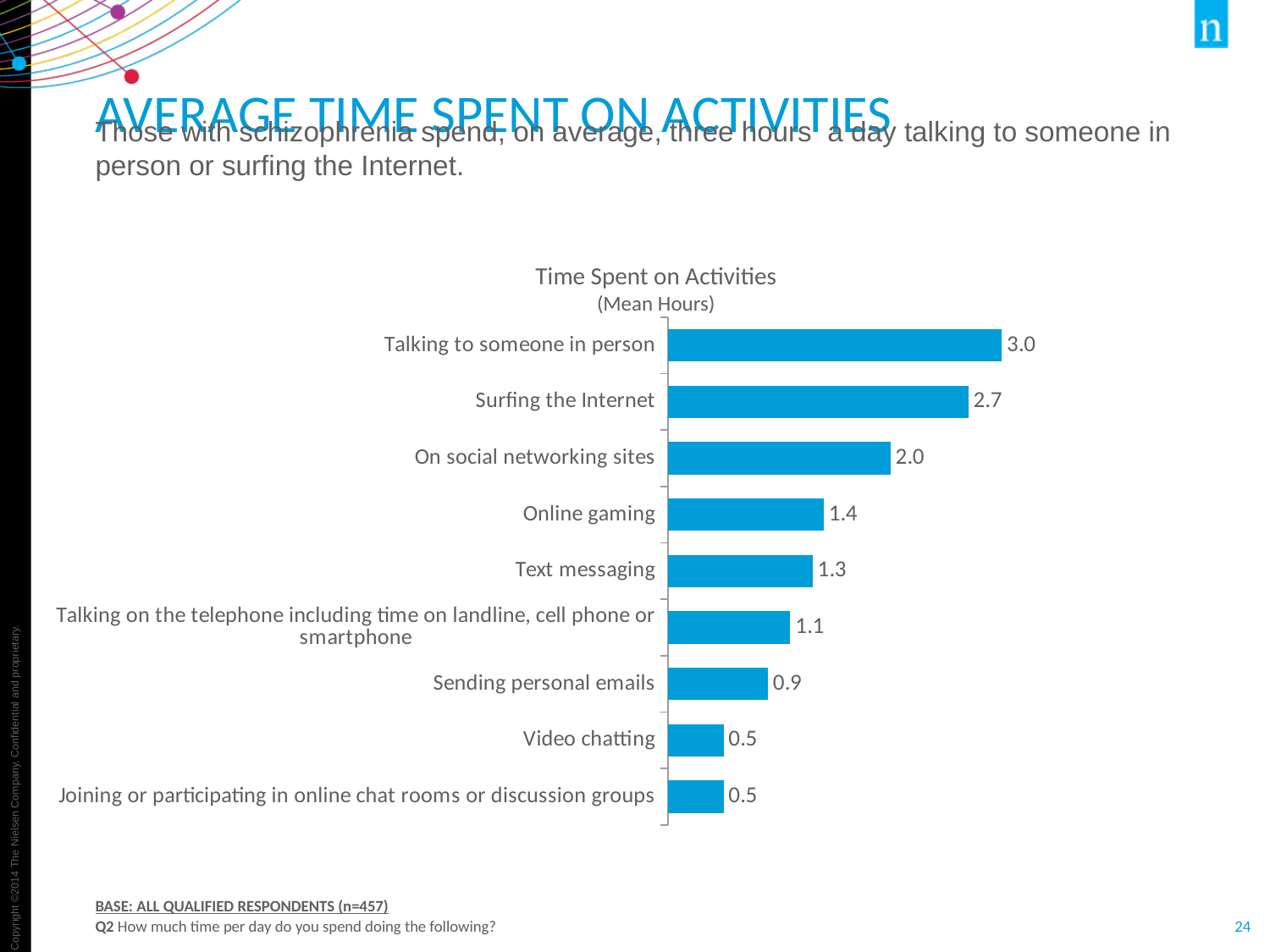
What is the mean hours value for Online gaming? 1.4 What is the mean hours value for Video chatting? 0.5 Which activity has the highest mean hours? Talking to someone in person Which has a higher mean hours value, Online gaming or Text messaging? Online gaming How many activities are shown in the chart? 9 What is the difference in mean hours between Talking to someone in person and Surfing the Internet? 0.3 What is the title of the chart? Time Spent on Activities (Mean Hours) Which has a higher mean hours value, Sending personal emails or Talking on the telephone including time on landline, cell phone or smartphone? Talking on the telephone including time on landline, cell phone or smartphone What is the mean hours value for Sending personal emails? 0.9 What is the mean hours value for Surfing the Internet? 2.7 What kind of chart is shown on the slide? Bar chart What is the difference in mean hours between On social networking sites and Text messaging? 0.7